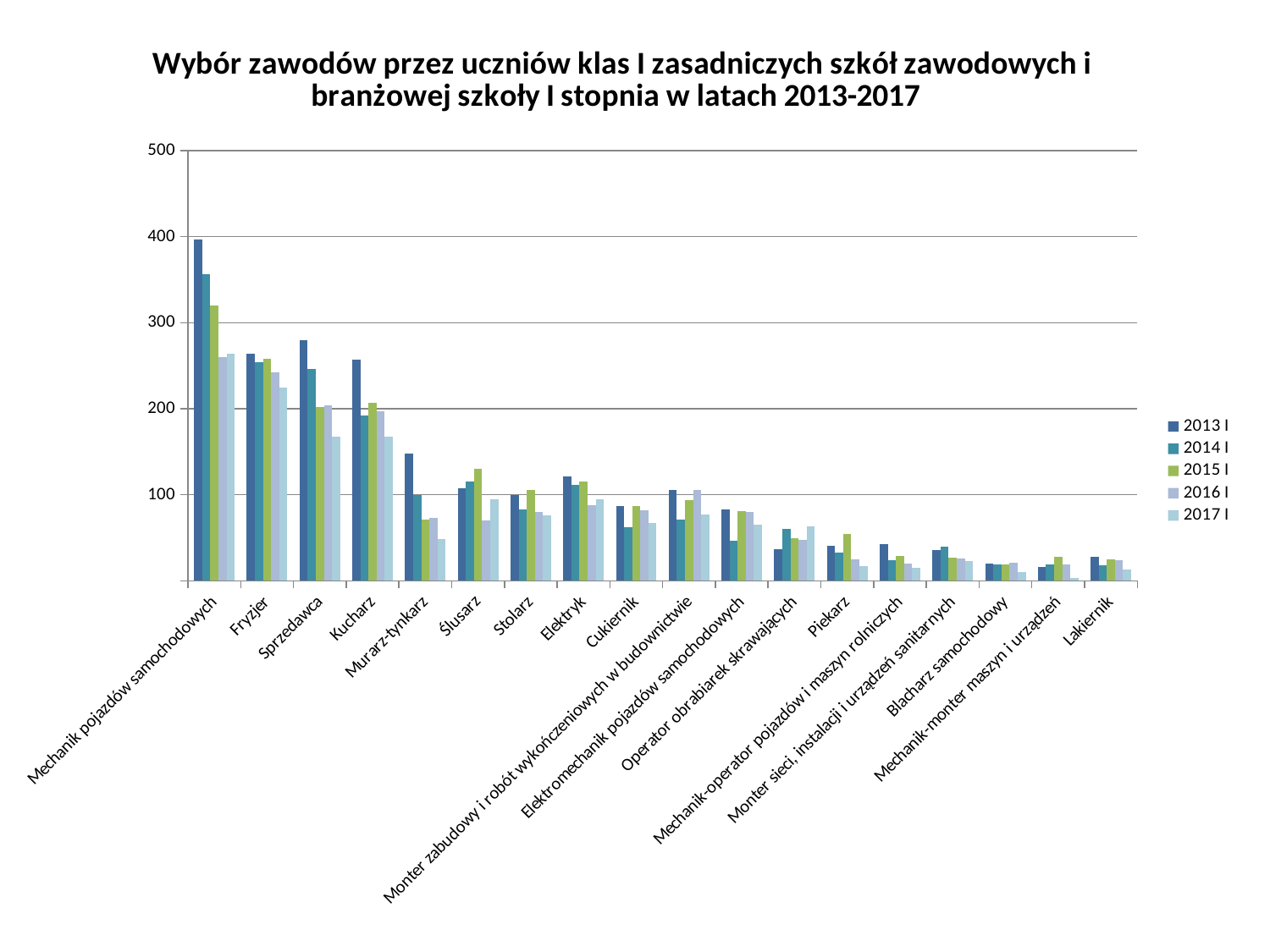
Is the 2013 I value for Sprzedawca greater or less than 200? greater Which occupation has the highest value for the 2013 I series? Mechanik pojazdów samochodowych How many series does the legend list? 5 How many occupation categories are shown on the x axis? 18 Is the 2015 I value for Ślusarz greater or less than 100? greater What is the last series listed in the legend? 2017 I Do the 2013 I values generally rise or fall moving from left to right along the x axis? fall Is the 2013 I value for Mechanik pojazdów samochodowych greater or less than 300? greater What kind of chart is shown on the slide? bar chart Which is larger for Murarz-tynkarz: the 2013 I value or the 2017 I value? 2013 I